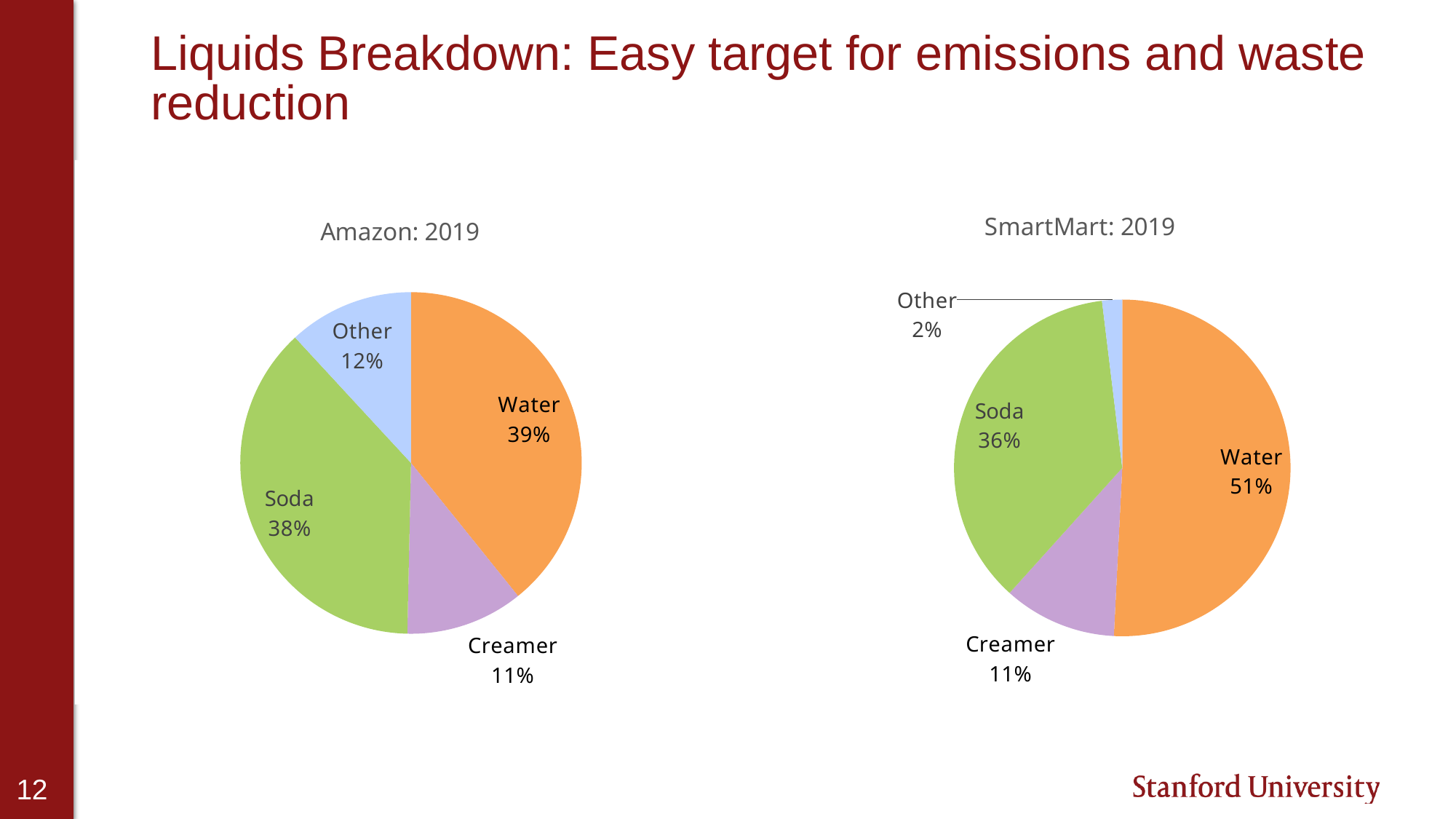
In the SmartMart: 2019 chart, which is larger, Creamer or Other? Creamer In the Amazon: 2019 chart, which category has the smallest share? Creamer In the Amazon: 2019 chart, what share does Water have? 39% In the SmartMart: 2019 chart, which category has the smallest share? Other In the Amazon: 2019 chart, what is the difference between the Soda share and the Other share? 26% In the Amazon: 2019 chart, which category has the largest share? Water How many categories does the Amazon: 2019 pie chart show? 4 What type of chart is the SmartMart: 2019 chart? Pie chart What is the title of the chart on the left side of the slide? Amazon: 2019 In the SmartMart: 2019 chart, what share does Other have? 2% In the SmartMart: 2019 chart, what is the difference between the Water share and the Soda share? 15% In the SmartMart: 2019 chart, what share does Soda have? 36%